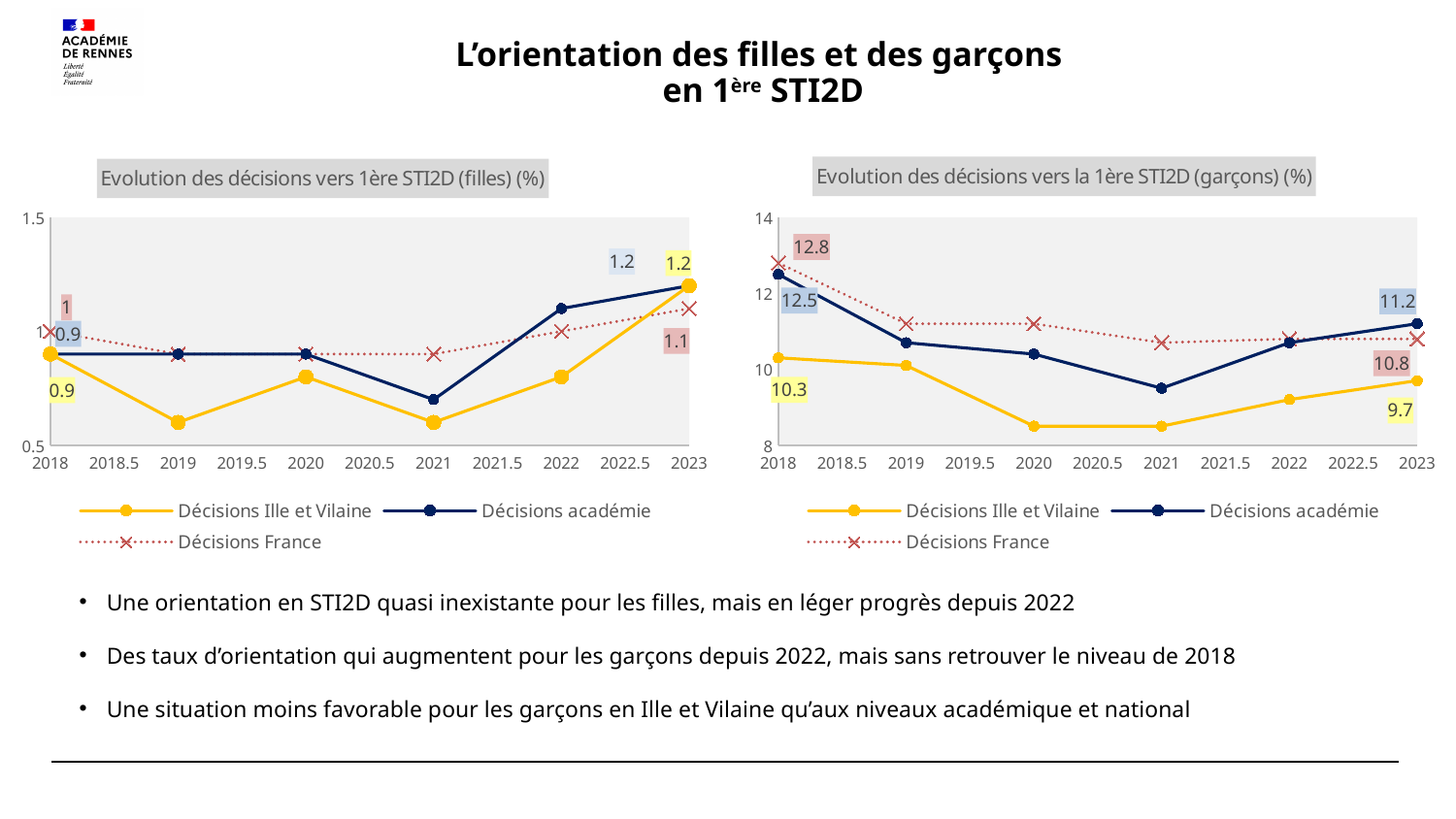
In the garçons chart (right), what is the value for Décisions France in 2018? 12.8 In the garçons chart (right), which is larger in 2018: Décisions France or Décisions Ille et Vilaine? Décisions France What type of chart is used on the slide for the filles and garçons data? Line chart In the garçons chart (right), what is the difference between Décisions académie and Décisions Ille et Vilaine in 2023? 1.5 In the garçons chart (right), is the value for Décisions Ille et Vilaine in 2021 greater or less than 10? less In the garçons chart (right), does Décisions Ille et Vilaine rise or fall from 2021 to 2023? rise In the garçons chart (right), what is the difference between Décisions France in 2018 and in 2023? 2 In the filles chart (left), what is the value for Décisions France in 2023? 1.1 In the garçons chart (right), what is the value for Décisions Ille et Vilaine in 2023? 9.7 In the garçons chart (right), how many series does the legend list? 3 What is the title of the left chart? Evolution des décisions vers 1ère STI2D (filles) (%) In the filles chart (left), what is the value for Décisions académie in 2023? 1.2